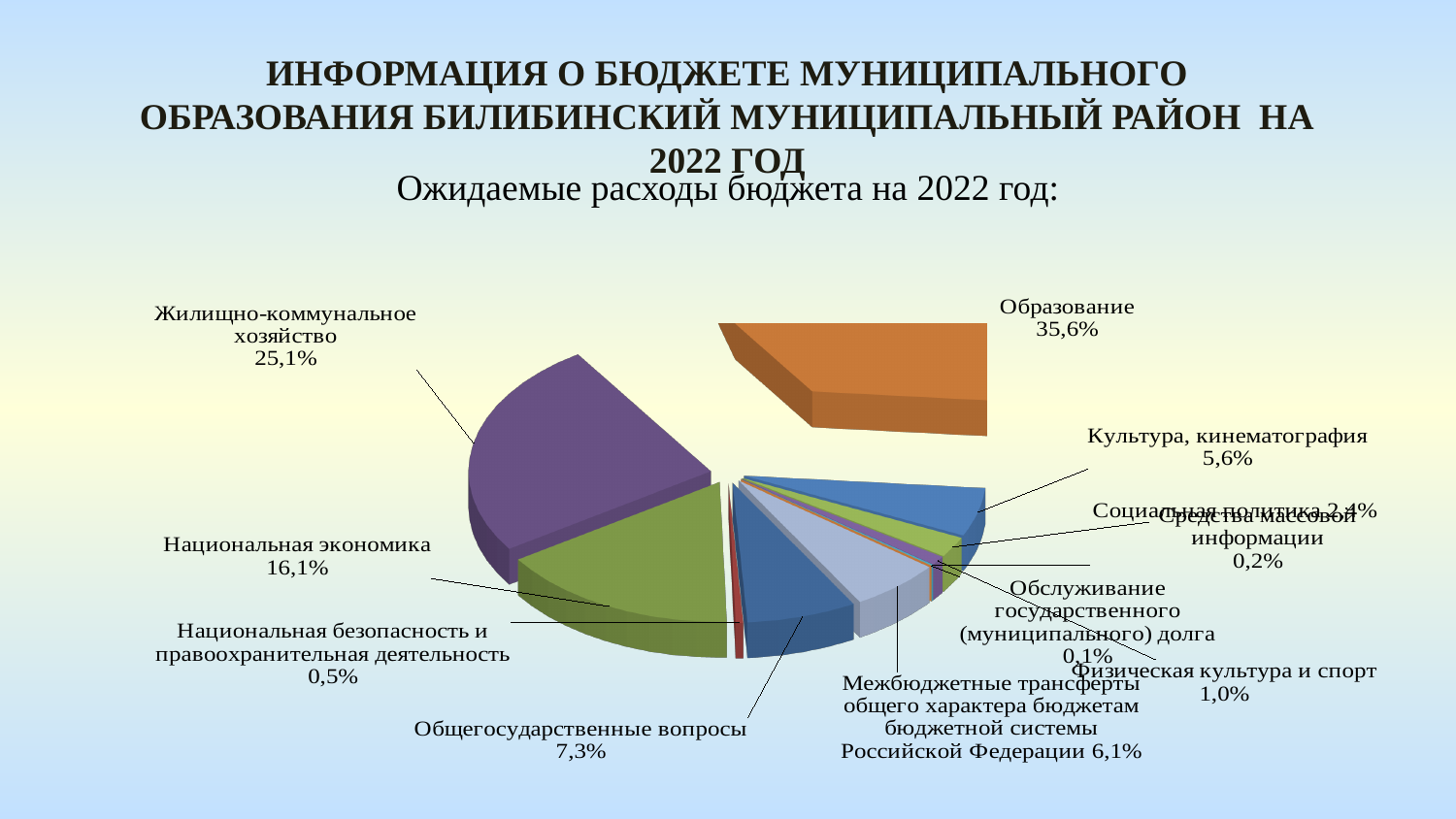
Which category has the largest share of the expected 2022 budget expenditures? Образование What share of expected expenditures goes to Национальная экономика? 16,1% What share of expected expenditures goes to Общегосударственные вопросы? 7,3% What share of expected expenditures goes to Физическая культура и спорт? 1,0% By how many percentage points does the share for Образование exceed the share for Жилищно-коммунальное хозяйство? 10,5 What kind of chart is shown on the slide? pie chart What share of expected expenditures goes to Жилищно-коммунальное хозяйство? 25,1% What share of expected expenditures goes to Культура, кинематография? 5,6% Which category has the smallest share of the expected 2022 budget expenditures? Обслуживание государственного (муниципального) долга How many expenditure categories are shown in the pie chart? 11 What share of expected expenditures goes to Образование? 35,6% Which has a larger share: Общегосударственные вопросы or Межбюджетные трансферты общего характера бюджетам бюджетной системы Российской Федерации? Общегосударственные вопросы